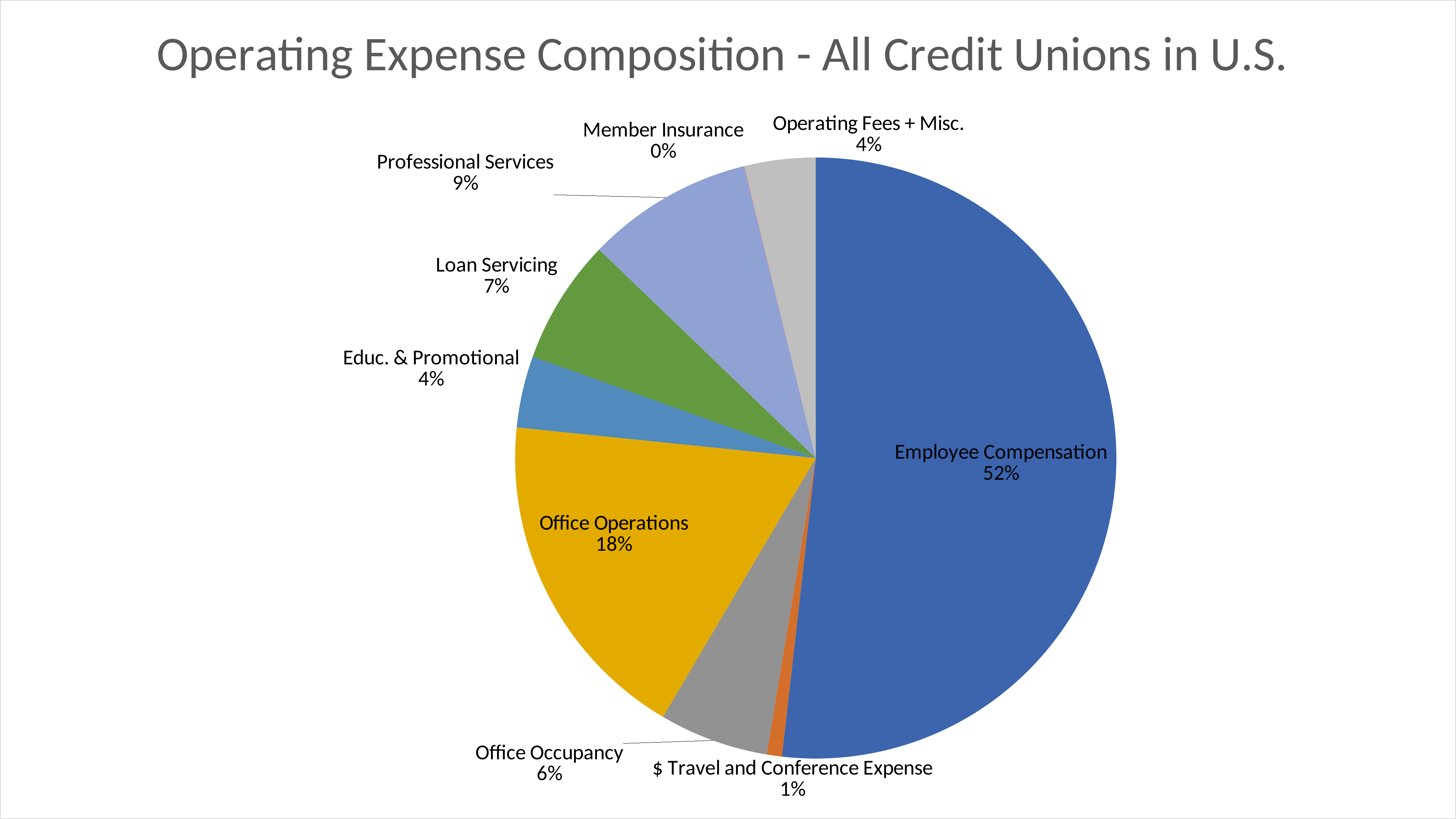
Which category has the smallest share of operating expenses? Member Insurance What percentage is shown for Loan Servicing? 7% What percentage is shown for Professional Services? 9% How many categories are shown in the pie chart? 9 What is the difference in percentage points between Employee Compensation and Office Operations? 34 What share of operating expenses is Office Operations? 18% What kind of chart is shown on the slide? Pie chart Which category has the largest share of operating expenses? Employee Compensation Which is larger, Office Occupancy or Loan Servicing? Loan Servicing What percentage is shown for Member Insurance? 0% What is the title of the chart? Operating Expense Composition - All Credit Unions in U.S. What share of operating expenses is Employee Compensation? 52%